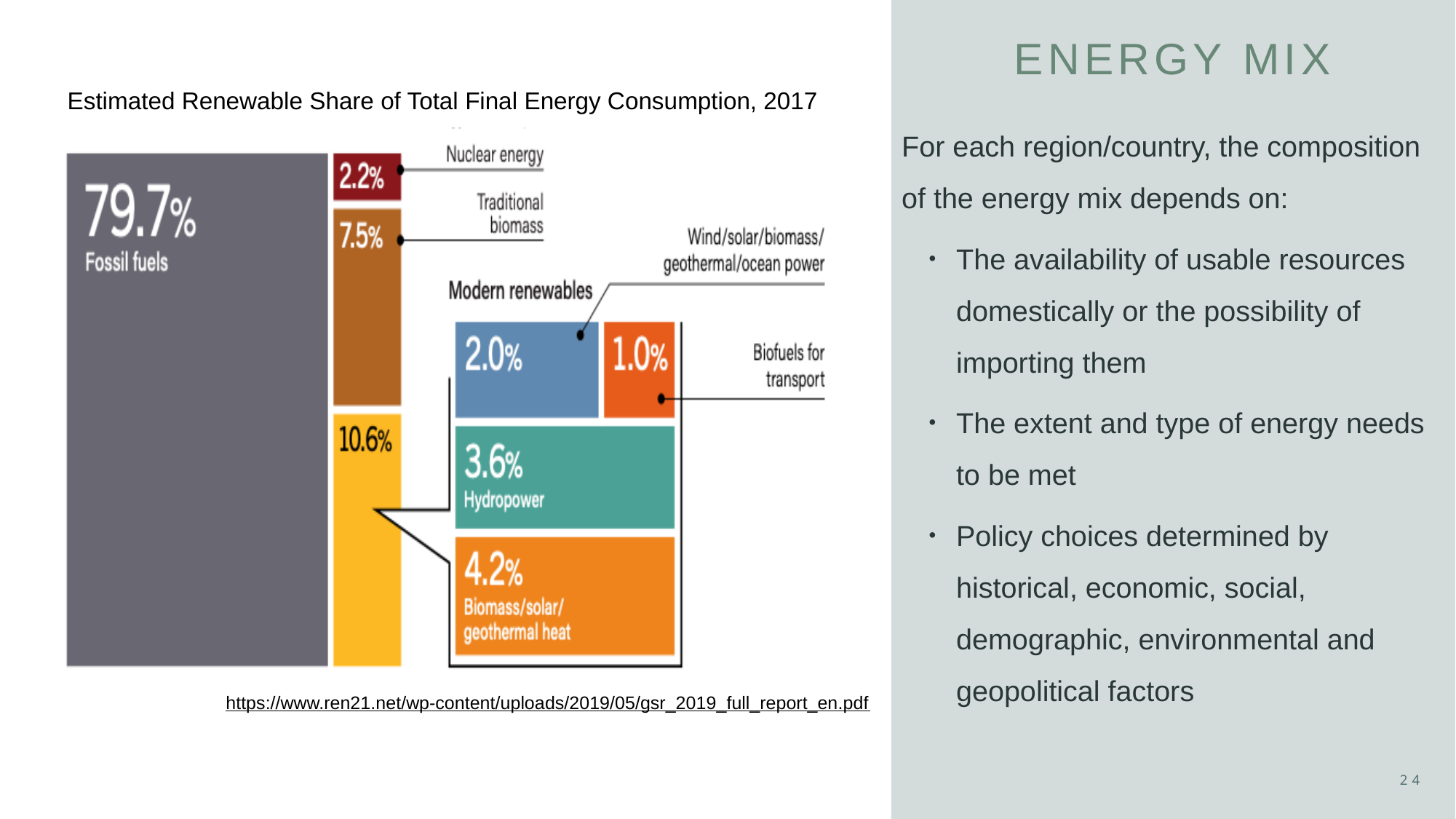
Which category within modern renewables has the smallest share? Biofuels for transport What is the share of biofuels for transport on the chart? 1.0% Which energy source has the largest share on the chart? Fossil fuels What is the difference between the share of traditional biomass and the share of nuclear energy? 5.3% What is the share of fossil fuels in total final energy consumption shown on the chart? 79.7% What is the share of traditional biomass on the chart? 7.5% What share does nuclear energy have according to the chart? 2.2% What share does hydropower have on the chart? 3.6% What is the combined share of hydropower and biomass/solar/geothermal heat? 7.8% Which has a larger share: hydropower or biomass/solar/geothermal heat? Biomass/solar/geothermal heat What is the total share of modern renewables shown on the chart? 10.6% What is the title of the chart on the slide? Estimated Renewable Share of Total Final Energy Consumption, 2017